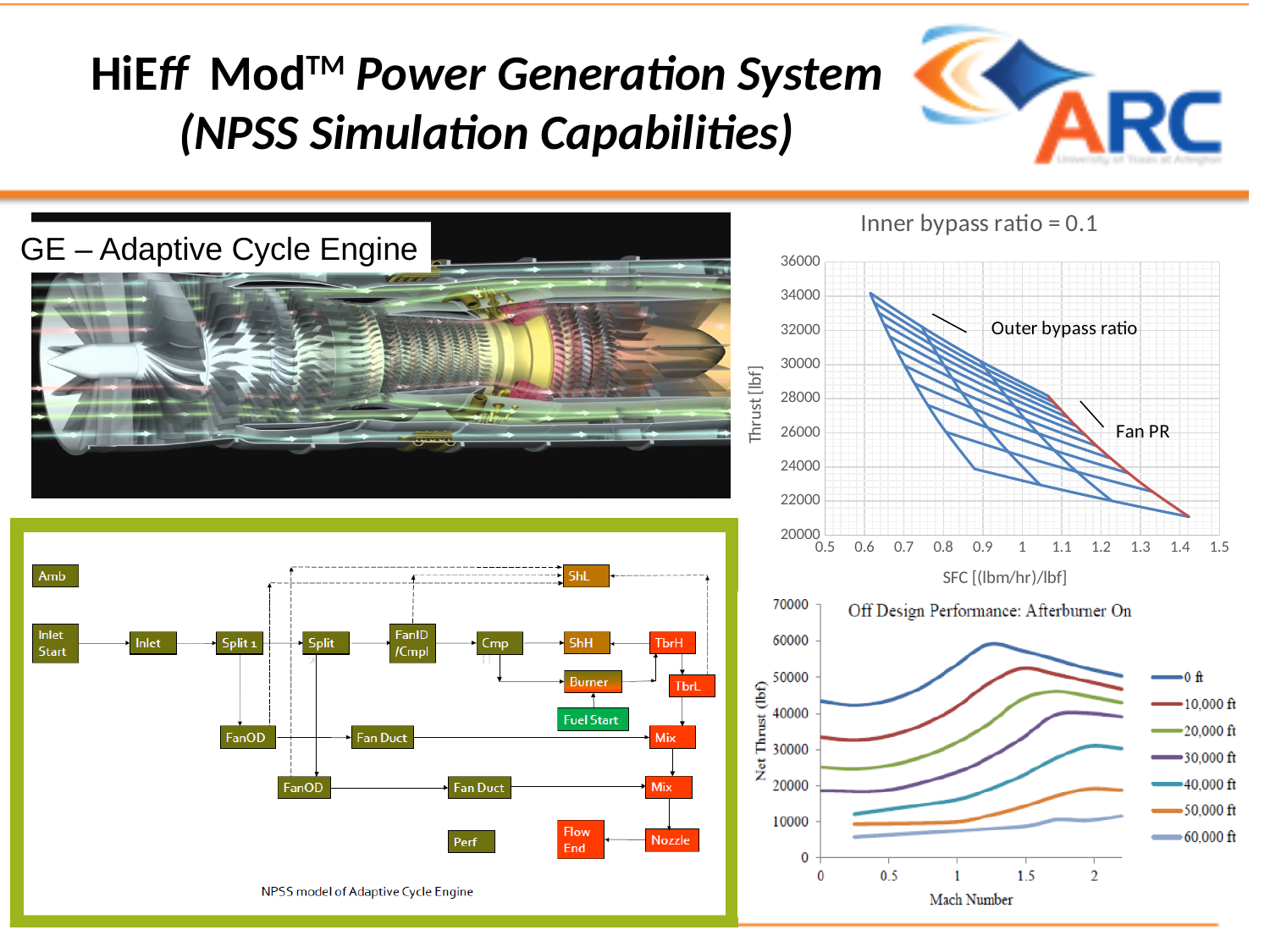
How many series does the legend of the "Off Design Performance: Afterburner On" chart list? 7 In the "Inner bypass ratio = 0.1" chart, is the highest thrust value plotted greater or less than 32000? greater In the "Off Design Performance: Afterburner On" chart, which series has a larger net thrust at Mach 1.5: 10,000 ft or 30,000 ft? 10,000 ft In the "Off Design Performance: Afterburner On" chart, is the net thrust for the 0 ft series at Mach 0 greater or less than 40000? greater What is the x-axis label of the "Off Design Performance: Afterburner On" chart? Mach Number What kind of chart is the top-right chart titled "Inner bypass ratio = 0.1"? Line chart In the "Inner bypass ratio = 0.1" chart, does thrust generally rise or fall as SFC increases along the x axis? Fall In the "Off Design Performance: Afterburner On" chart, is the peak net thrust of the 50,000 ft series greater or less than 20000? less In the "Off Design Performance: Afterburner On" chart, which altitude series has the highest net thrust? 0 ft What kind of chart is the bottom-right chart titled "Off Design Performance: Afterburner On"? Line chart In the "Off Design Performance: Afterburner On" chart, which altitude series has the lowest net thrust? 60,000 ft